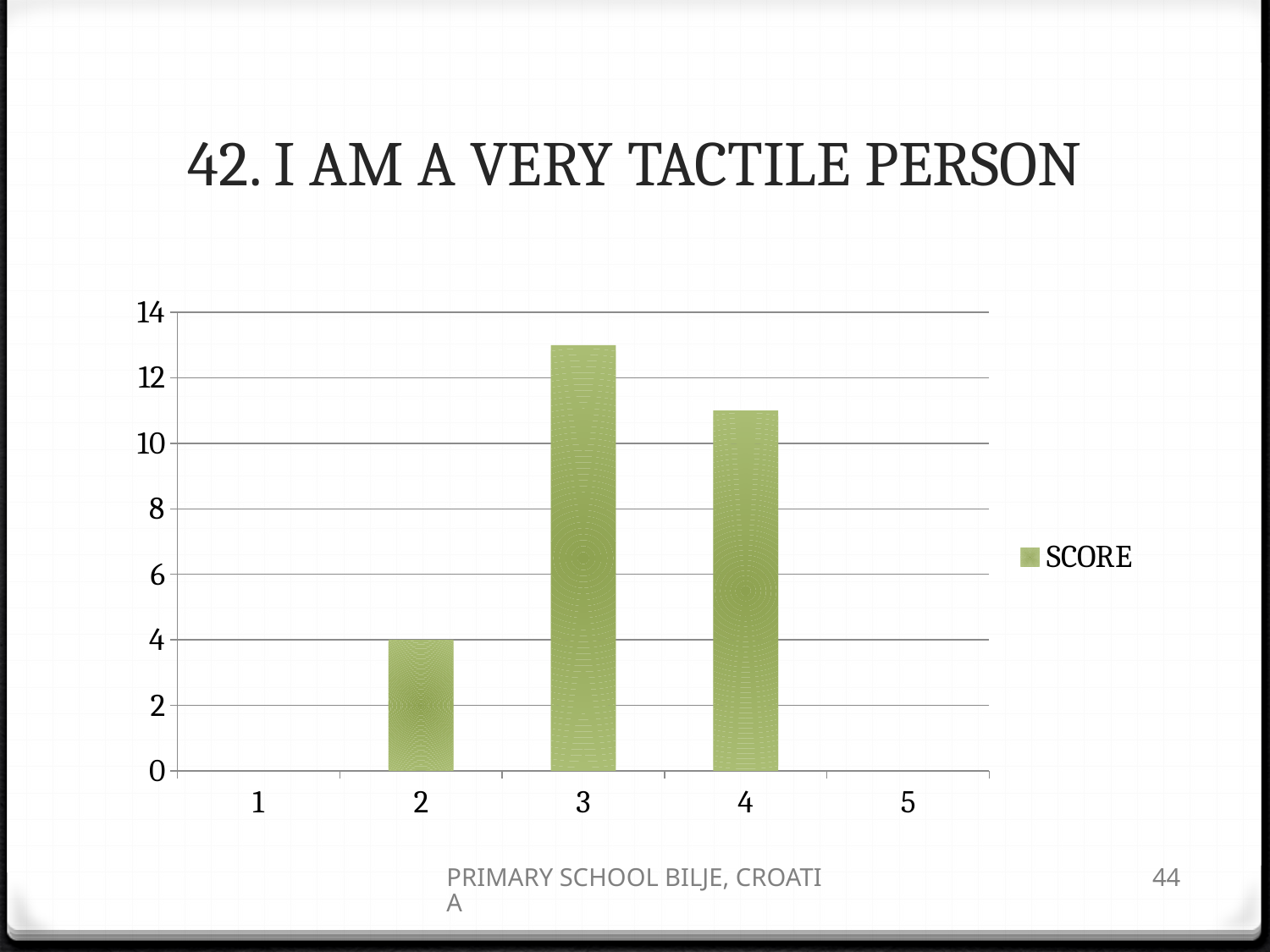
Which has a higher SCORE, category 3 or category 4? 3 Is the SCORE for category 4 greater or less than 10? greater Is the SCORE for category 4 greater or less than 12? less Is the SCORE for category 3 greater or less than 12? greater What is the title of the chart? 42. I AM A VERY TACTILE PERSON How many series does the legend list? 1 How many categories are shown on the x axis? 5 Which has a higher SCORE, category 2 or category 4? 4 Which category has the highest SCORE? 3 What is the SCORE value for category 2? 4 What series name does the legend show? SCORE What type of chart is shown on the slide? bar chart